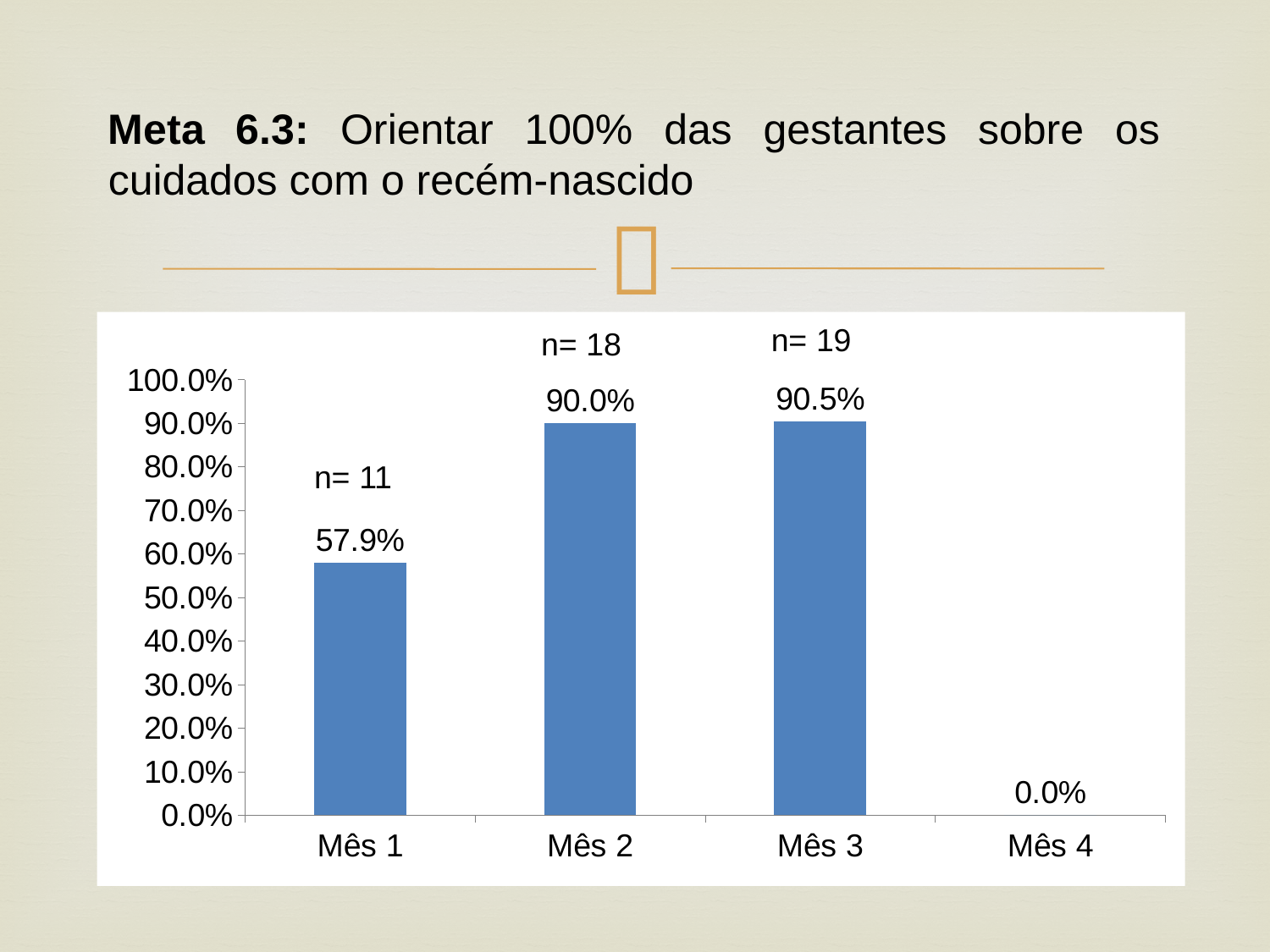
What is the value for Mês 2? 90.0% What is the n value annotated above the bar for Mês 3? n= 19 What kind of chart is shown on the slide? bar chart How many months are shown on the x axis? 4 Which month has the highest value? Mês 3 Is the value for Mês 1 greater or less than 50.0%? greater What is the difference between the values for Mês 2 and Mês 1? 32.1% Which month has the lowest value? Mês 4 What is the value for Mês 4? 0.0% Which is larger, the value for Mês 1 or the value for Mês 2? Mês 2 What is the value for Mês 3? 90.5% What is the value for Mês 1? 57.9%